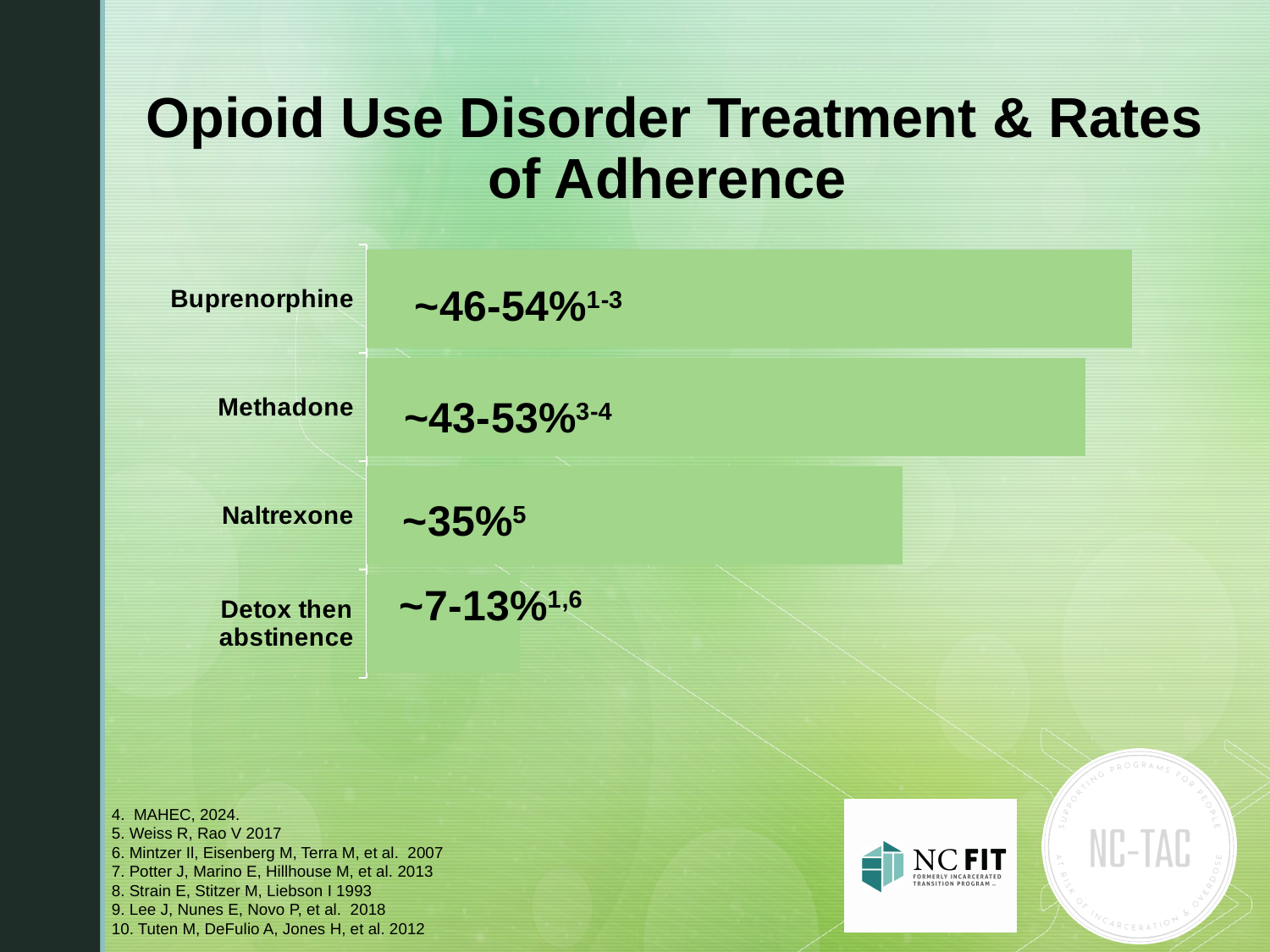
What adherence rate is printed on the bar for Detox then abstinence? ~7-13% Which has a higher adherence rate, Buprenorphine or Naltrexone? Buprenorphine Which treatment has the shortest bar in the chart? Detox then abstinence Do the bar lengths increase or decrease going from the top bar to the bottom bar? decrease What adherence rate is printed on the bar for Buprenorphine? ~46-54% What adherence rate is printed on the bar for Naltrexone? ~35% What is the title of the slide containing the chart? Opioid Use Disorder Treatment & Rates of Adherence Which has a higher adherence rate, Naltrexone or Detox then abstinence? Naltrexone What adherence rate is printed on the bar for Methadone? ~43-53% Which treatment has the longest bar in the chart? Buprenorphine How many treatment categories are shown in the chart? 4 What kind of chart is shown on the slide? bar chart